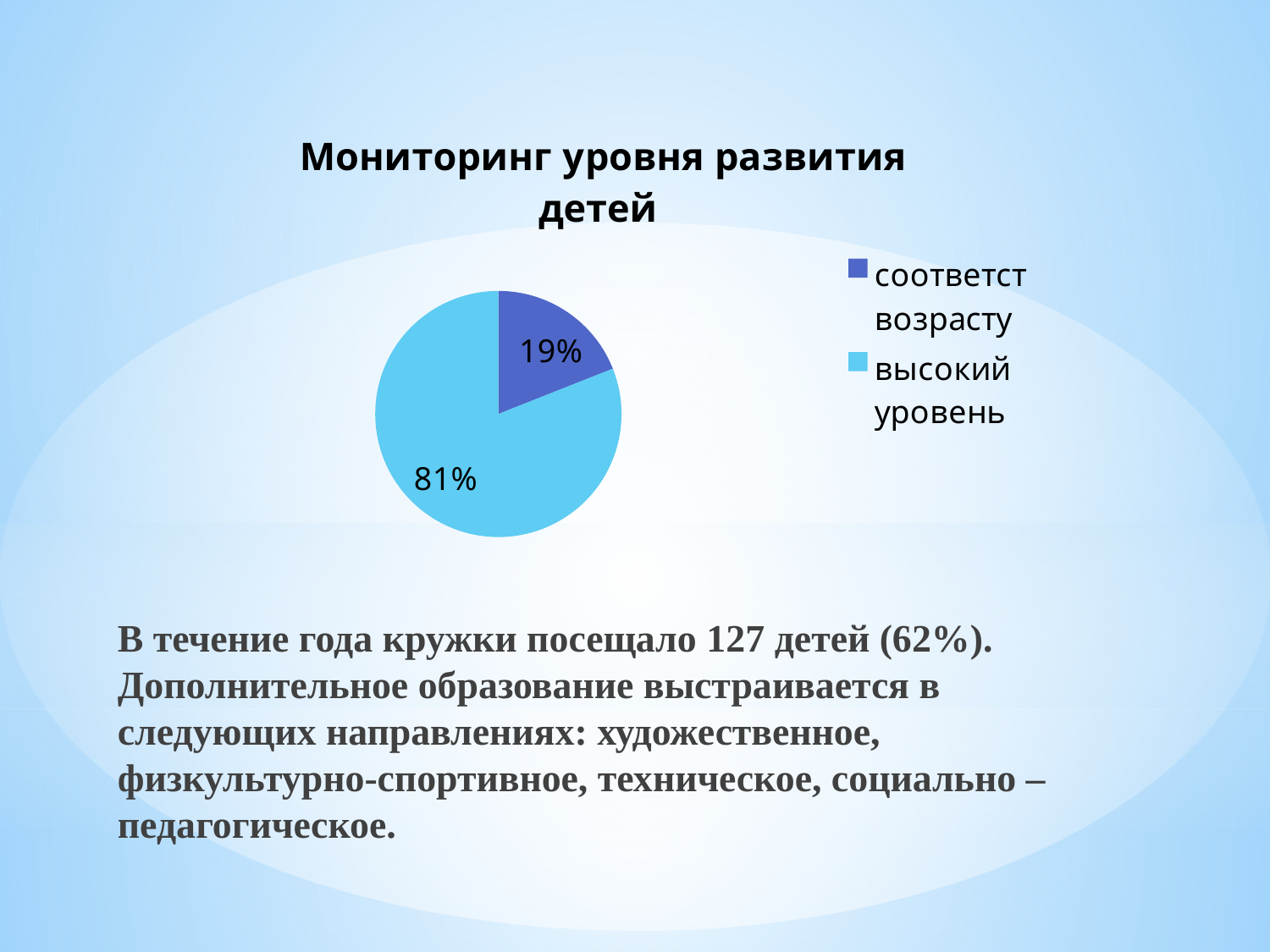
How many slices does the pie chart have? 2 What share of the pie is labelled "соответст возрасту"? 19% Which is larger: the "соответст возрасту" slice or the "высокий уровень" slice? высокий уровень How many entries does the legend list? 2 What colour is the "высокий уровень" slice? light blue What kind of chart is shown on the slide? pie chart What is the difference in percentage points between the "высокий уровень" slice and the "соответст возрасту" slice? 62 What is the title of the chart? Мониторинг уровня развития детей Which slice of the pie is the largest? высокий уровень What share of the pie is labelled "высокий уровень"? 81% Which slice of the pie is the smallest? соответст возрасту